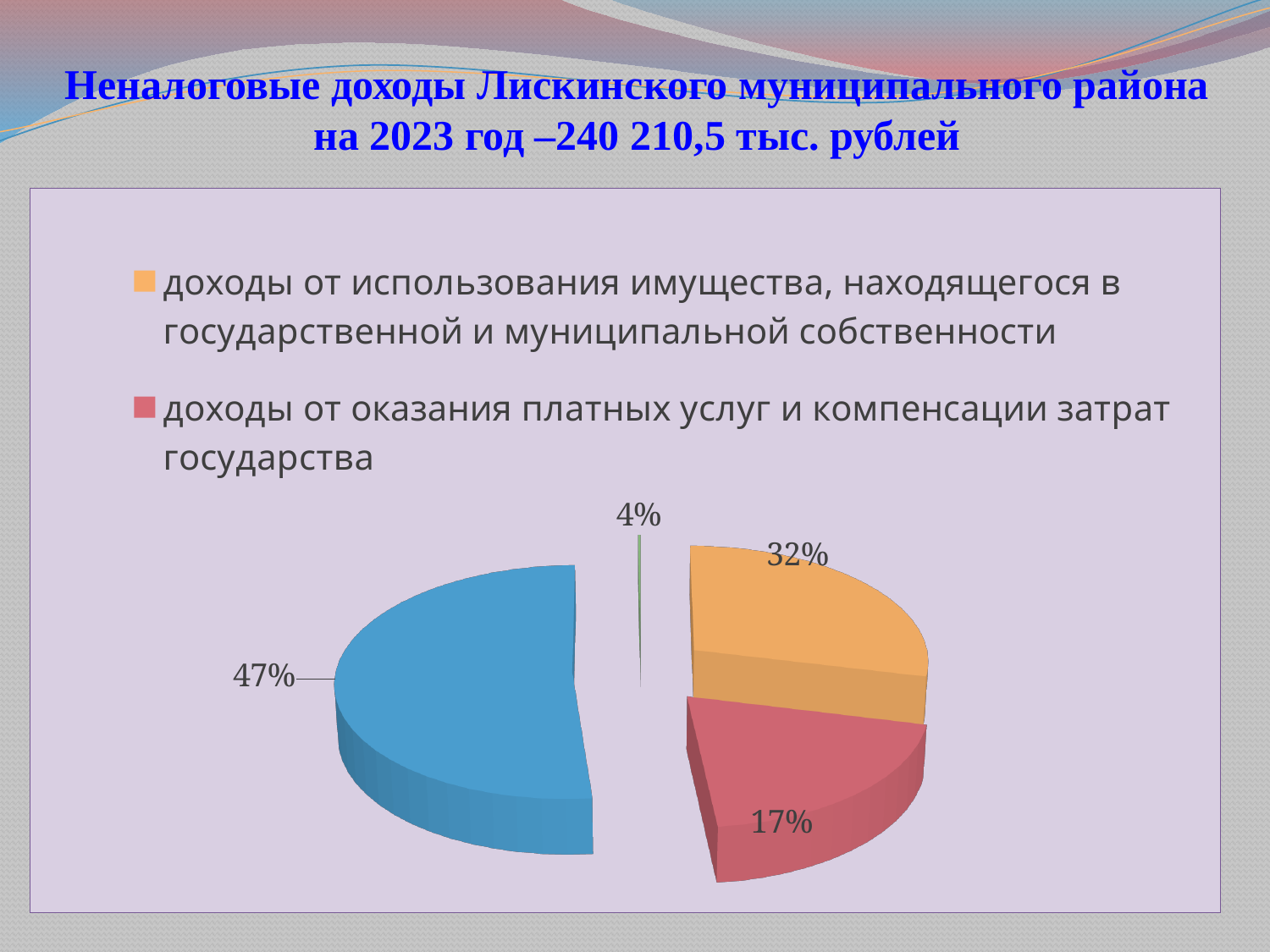
By how many percentage points does the orange slice (32%) exceed the red slice (17%)? 15 percentage points What share of the pie is labelled for 'доходы от оказания платных услуг и компенсации затрат государства' (red slice)? 17% What colour is the slice labelled 47%? blue What share of the pie is labelled for 'доходы от использования имущества, находящегося в государственной и муниципальной собственности' (orange slice)? 32% What total amount of non-tax revenue for 2023 is stated in the slide title? 240 210,5 тыс. рублей What is the largest percentage shown on the pie chart? 47% Is the share of the blue slice greater or less than 40%? greater Which slice is larger: the orange slice (доходы от использования имущества) or the red slice (доходы от оказания платных услуг)? the orange slice (доходы от использования имущества) How many slices does the pie chart have? 4 How many entries are listed in the chart legend? 2 What is the smallest percentage shown on the pie chart? 4% What kind of chart is shown on the slide? pie chart